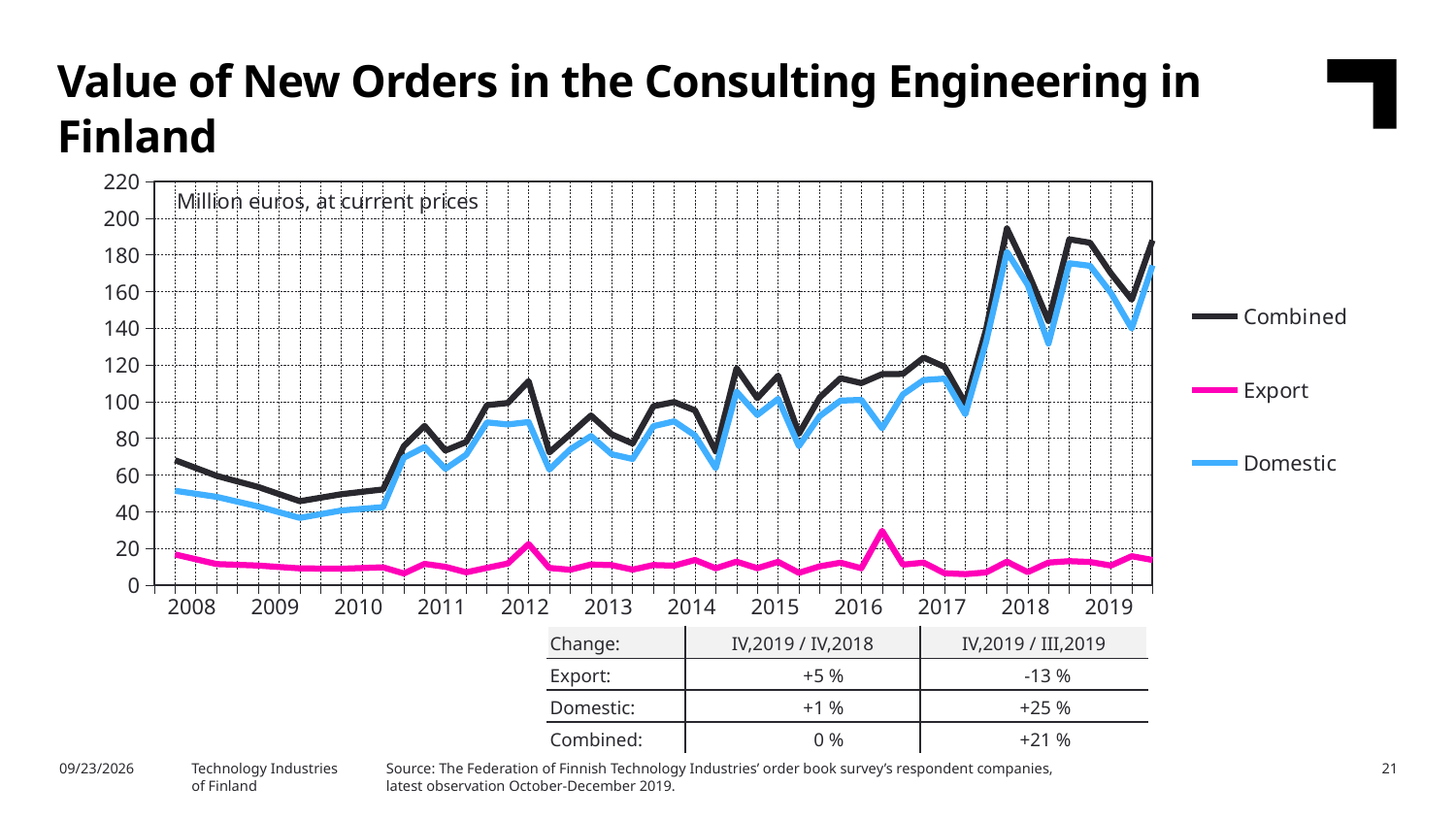
Is the peak value for Export in 2016 greater or less than 20? greater Which is larger in 2018, the Domestic value or the Export value? Domestic Which series is plotted with the highest values throughout the chart? Combined Does the Combined series rise or fall from 2017 to 2018? rise What kind of chart is shown on the slide? line chart Which series is plotted with the lowest values throughout the chart? Export Is the value for Domestic in 2009 greater or less than 60? less Is the peak value for Combined in 2018 greater or less than 180? greater How many years are labelled on the x axis? 12 How many series does the legend list? 3 What unit is stated in the label inside the chart area? Million euros, at current prices